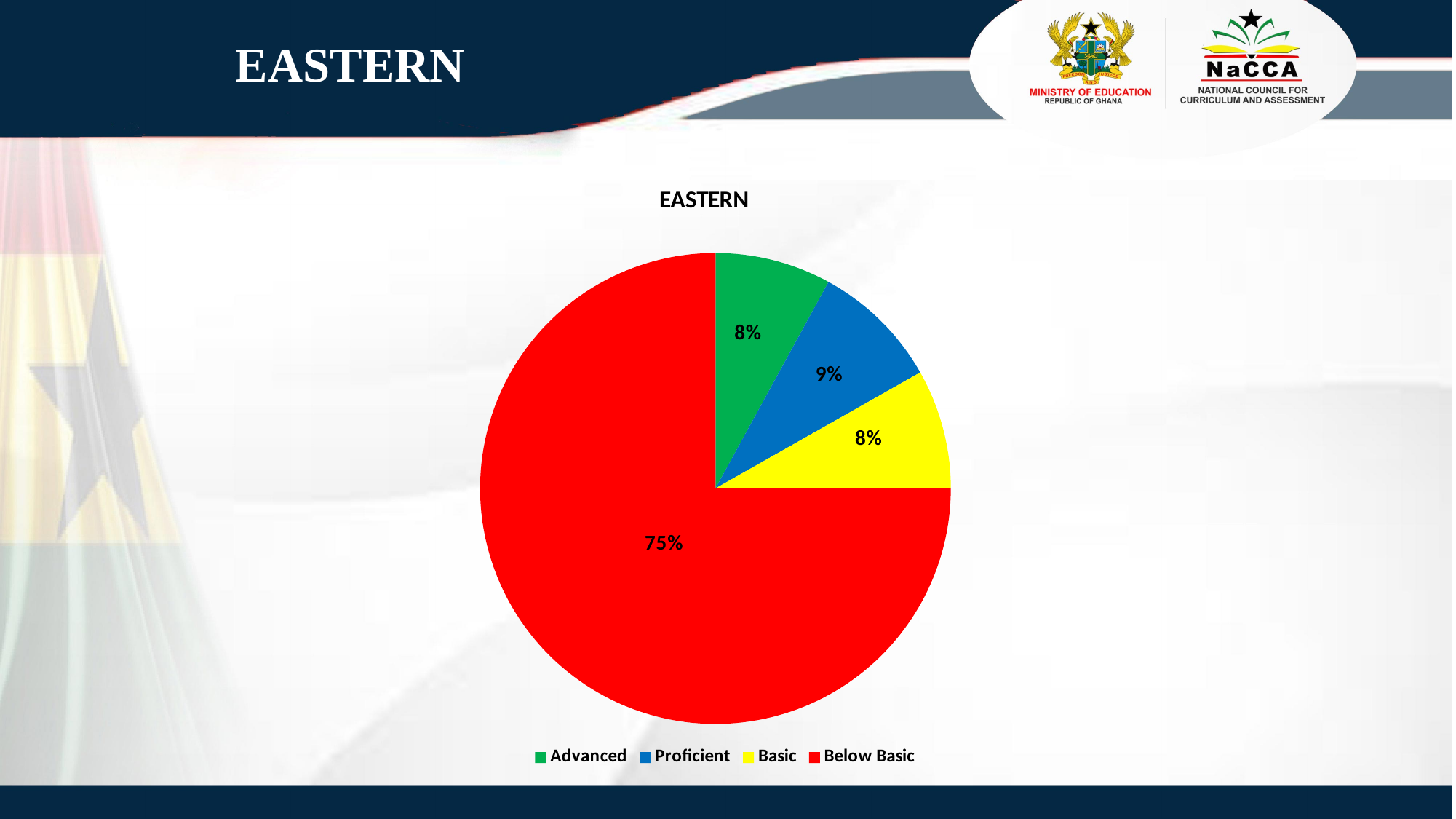
What type of chart is shown on the slide? pie chart Which is larger, the Proficient share or the Basic share? Proficient What colour is the Below Basic slice? red What is the difference in percentage points between Below Basic and Proficient? 66 What percentage of the pie is Proficient? 9% What is the title of the chart? EASTERN How many categories does the legend list? 4 What percentage of the pie is Basic? 8% Which category has the largest share of the pie? Below Basic What percentage of the pie is Advanced? 8% What percentage of the pie is Below Basic? 75% What is the combined share of Advanced and Proficient? 17%